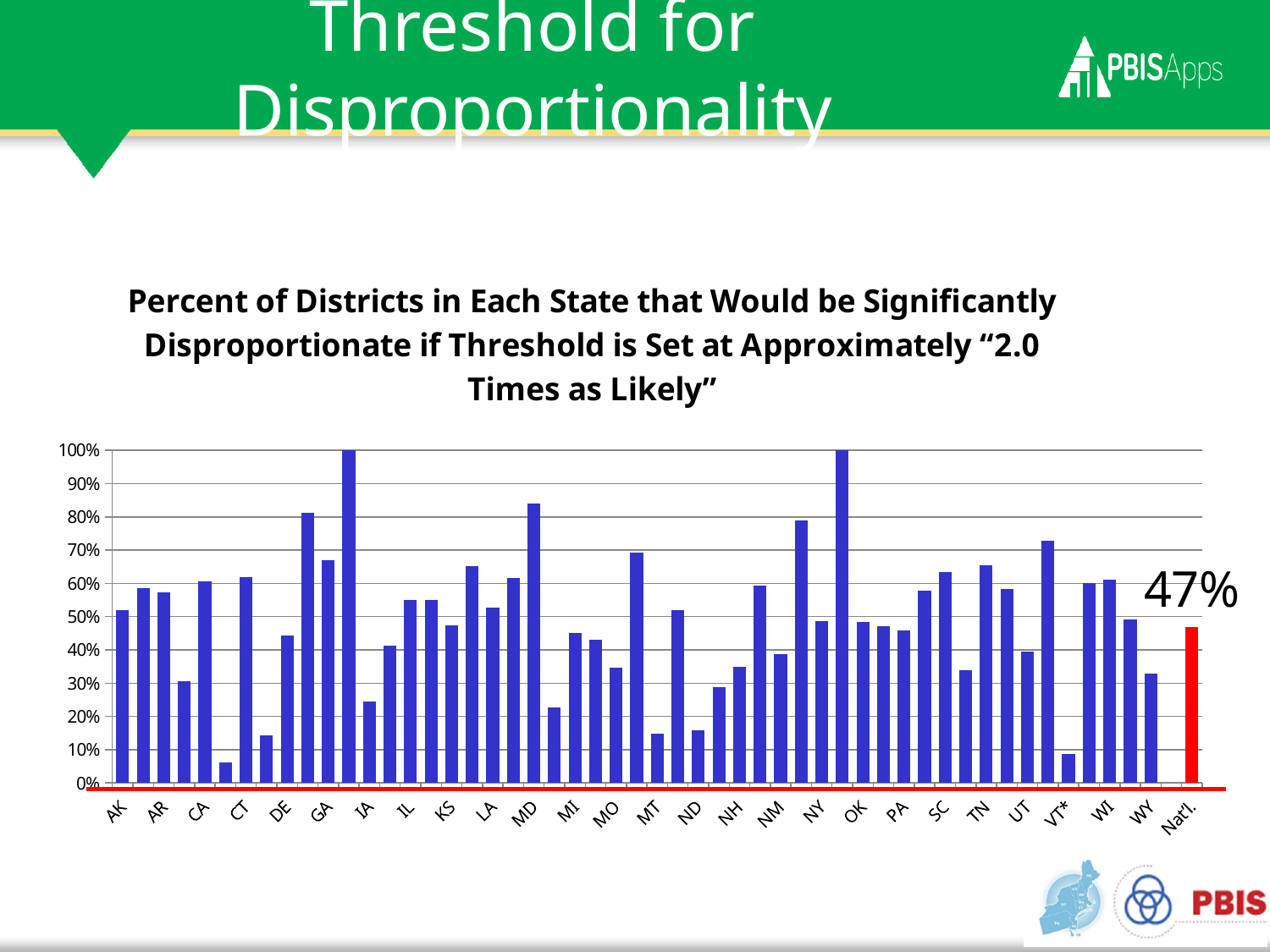
Is the value for WY greater or less than 40%? less What is the title of the chart? Percent of Districts in Each State that Would be Significantly Disproportionate if Threshold is Set at Approximately "2.0 Times as Likely" Which has the larger value, MD or IA? MD Is the value for GA greater or less than 60%? greater Is the value for VT* greater or less than 20%? less Which has the larger value, CT or VT*? CT What colour is the Nat'l bar? red What value is printed for the Nat'l bar? 47% What kind of chart is shown on the slide? bar chart